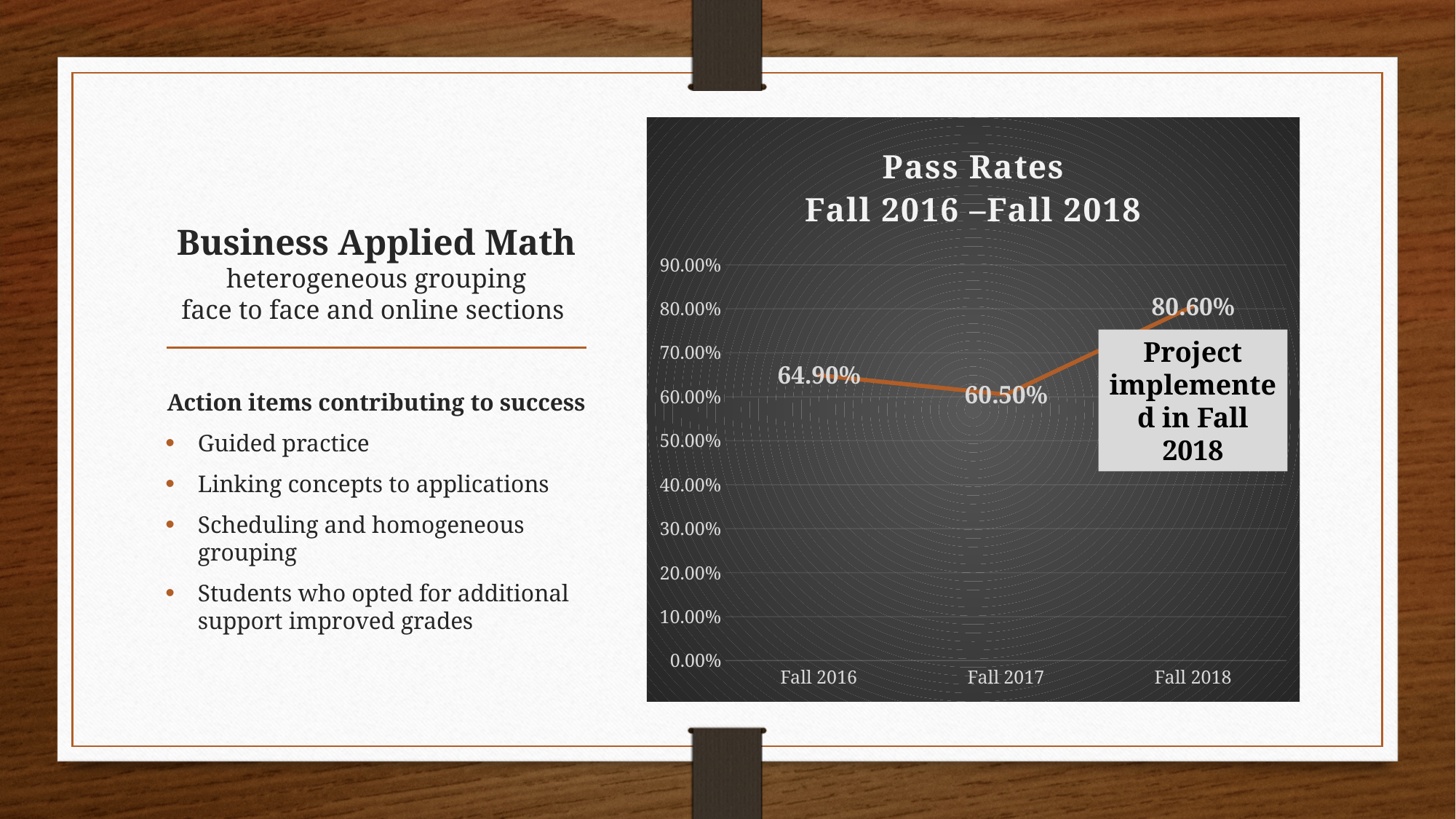
What is the pass rate for Fall 2018? 80.60% What kind of chart is shown on the slide? line chart Which term has the lowest pass rate? Fall 2017 What is the title of the chart? Pass Rates Fall 2016 –Fall 2018 What is the difference between the pass rates for Fall 2018 and Fall 2017? 20.10% Is the pass rate for Fall 2018 greater or less than 80.00%? greater What is the pass rate for Fall 2017? 60.50% Which term has the highest pass rate? Fall 2018 How many terms are plotted on the chart? 3 Which is larger, the pass rate for Fall 2016 or for Fall 2017? Fall 2016 What is the pass rate for Fall 2016? 64.90% What is the difference between the pass rates for Fall 2016 and Fall 2017? 4.40%